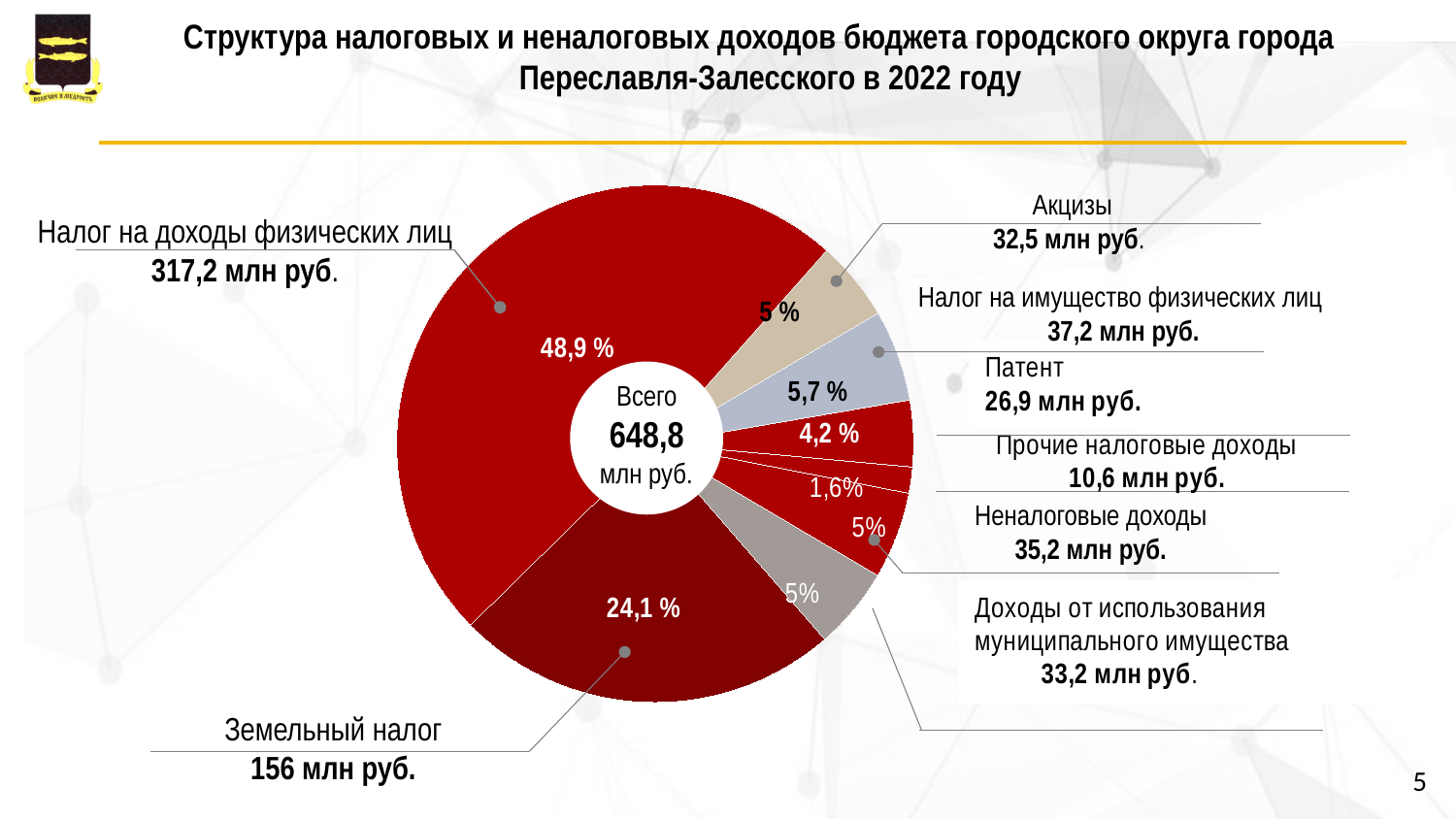
What type of chart is shown on the slide? pie chart (donut) What is the value for Земельный налог? 156 млн руб. What percentage share does Налог на доходы физических лиц have? 48,9 % Which category has the smallest share of the budget revenues? Прочие налоговые доходы What is the value for Акцизы? 32,5 млн руб. What is the value for Неналоговые доходы? 35,2 млн руб. How many categories are shown in the chart? 8 What is the total of all revenues shown in the centre of the chart? 648,8 млн руб. What is the value for Налог на доходы физических лиц? 317,2 млн руб. What is the difference between Налог на имущество физических лиц and Акцизы? 4,7 млн руб. Which category has the largest share of the budget revenues? Налог на доходы физических лиц What is the value for Патент? 26,9 млн руб.